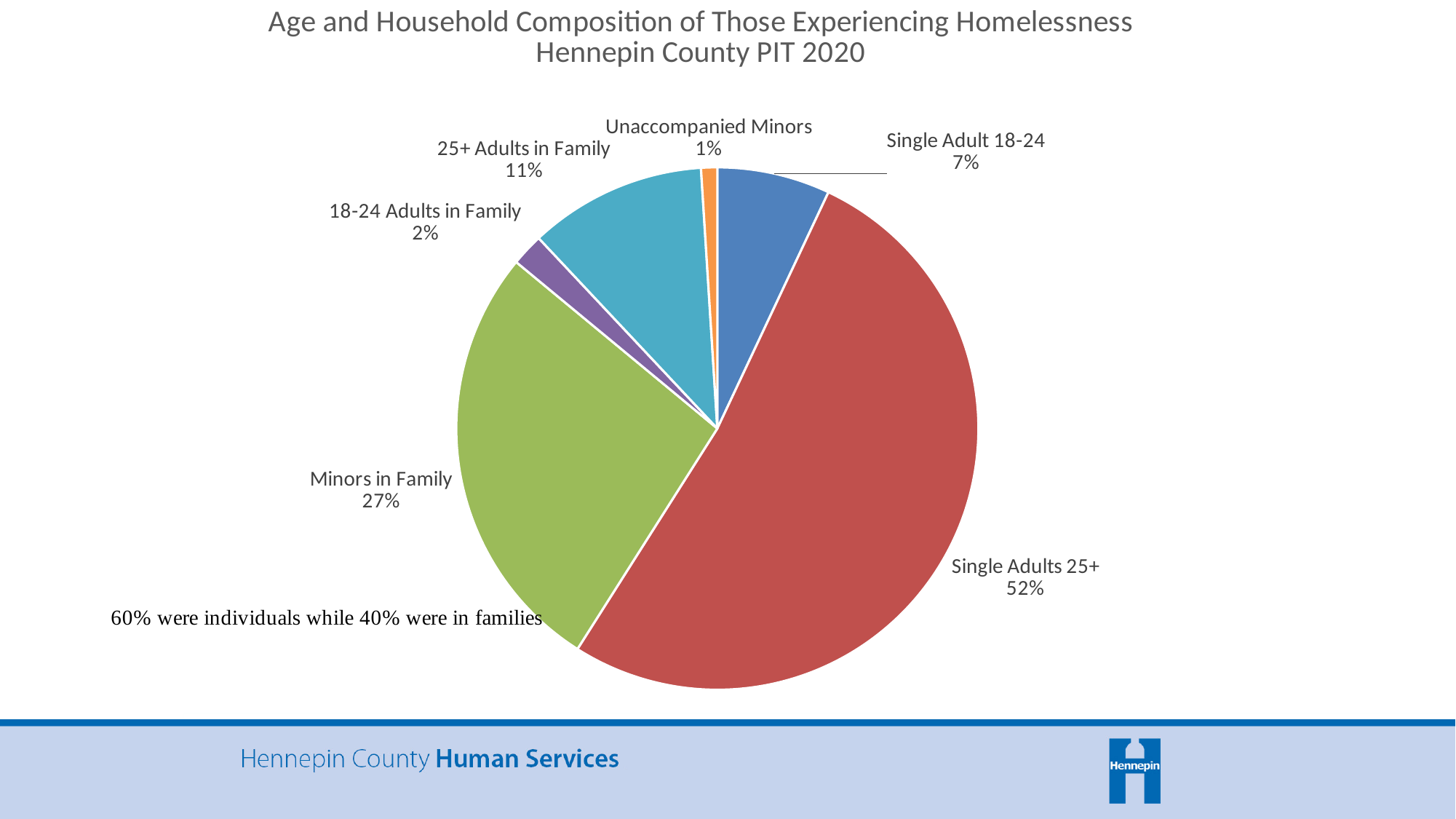
What percentage is shown for Unaccompanied Minors? 1% What is the difference in percentage points between Single Adults 25+ and Minors in Family? 25 Which category has the smallest slice of the pie? Unaccompanied Minors What percentage is shown for Single Adult 18-24? 7% What share of the pie is Minors in Family? 27% Which category has the largest slice of the pie? Single Adults 25+ What share of the pie is Single Adults 25+? 52% How many categories are shown in the pie chart? 6 What kind of chart is shown on the slide? Pie chart What percentage is shown for 25+ Adults in Family? 11% Which is larger, 25+ Adults in Family or Single Adult 18-24? 25+ Adults in Family What is the title of the chart? Age and Household Composition of Those Experiencing Homelessness Hennepin County PIT 2020